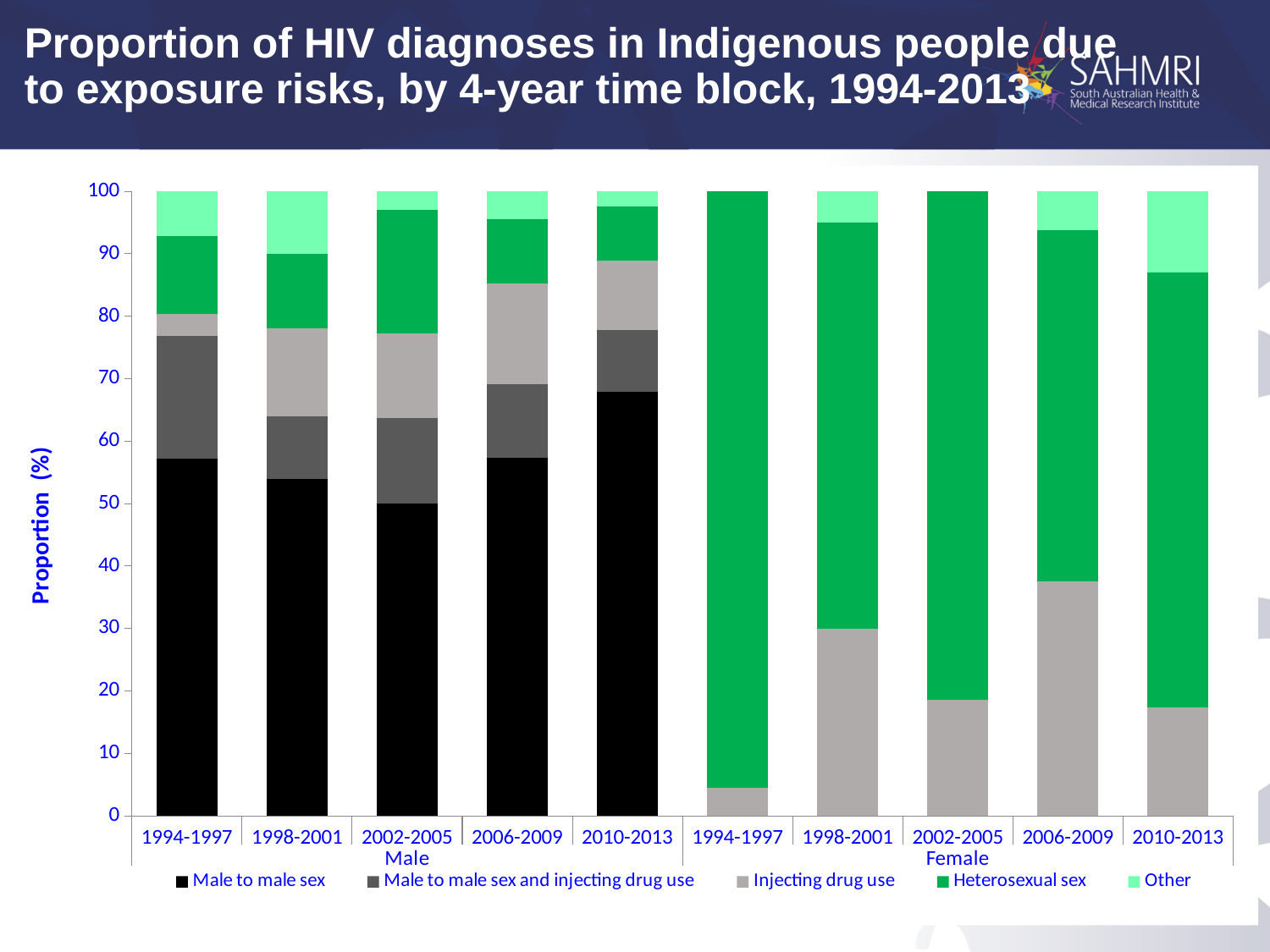
What kind of chart is shown on the slide? Stacked bar chart How many series does the legend list? 5 Is the value for Heterosexual sex in the Female 1994-1997 bar greater or less than 90? greater How many bars are plotted in the chart? 10 Among the Female time blocks, which has the smallest Injecting drug use segment? 1994-1997 Among the Male time blocks, which has the largest Male to male sex segment? 2010-2013 Is the value for Injecting drug use in the Female 2006-2009 bar greater or less than 30? greater What is the label on the vertical axis? Proportion (%) Which is larger: the Male to male sex segment for Male 1994-1997 or for Male 2002-2005? Male 1994-1997 Is the value for Male to male sex in the Male 1994-1997 bar greater or less than 50? greater What is the total of the stacked bar for Male 1994-1997? 100